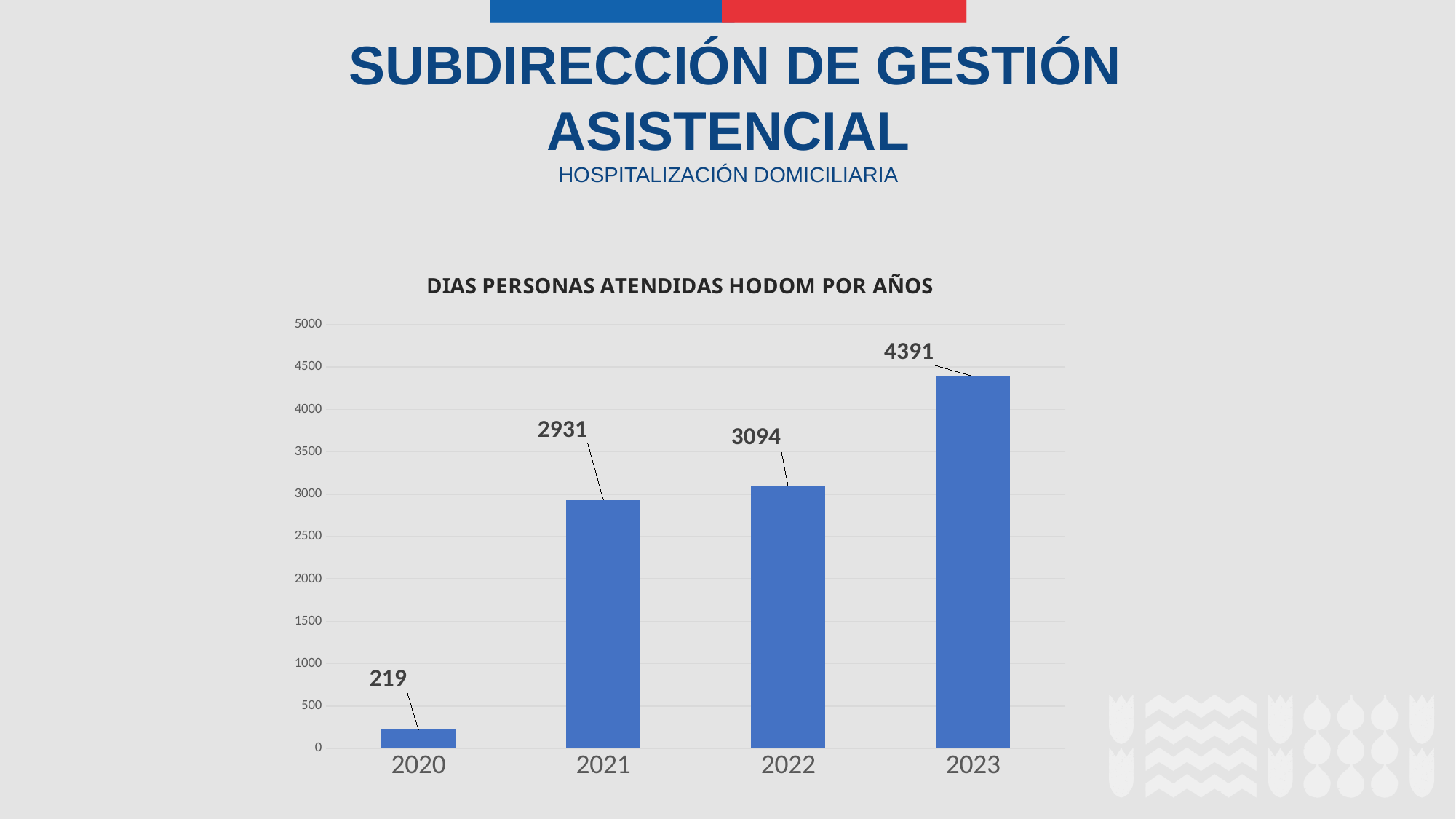
How many years are shown on the chart? 4 Which year has the lowest value? 2020 What is the value for 2021? 2931 What is the value for 2022? 3094 What is the value for 2020? 219 What is the difference between the values for 2021 and 2020? 2712 What kind of chart is this? Bar chart Do the values rise or fall from 2020 to 2023? Rise What is the difference between the values for 2023 and 2022? 1297 Which year has the highest value? 2023 What is the value for 2023? 4391 Which is larger, the value for 2021 or the value for 2022? 2022